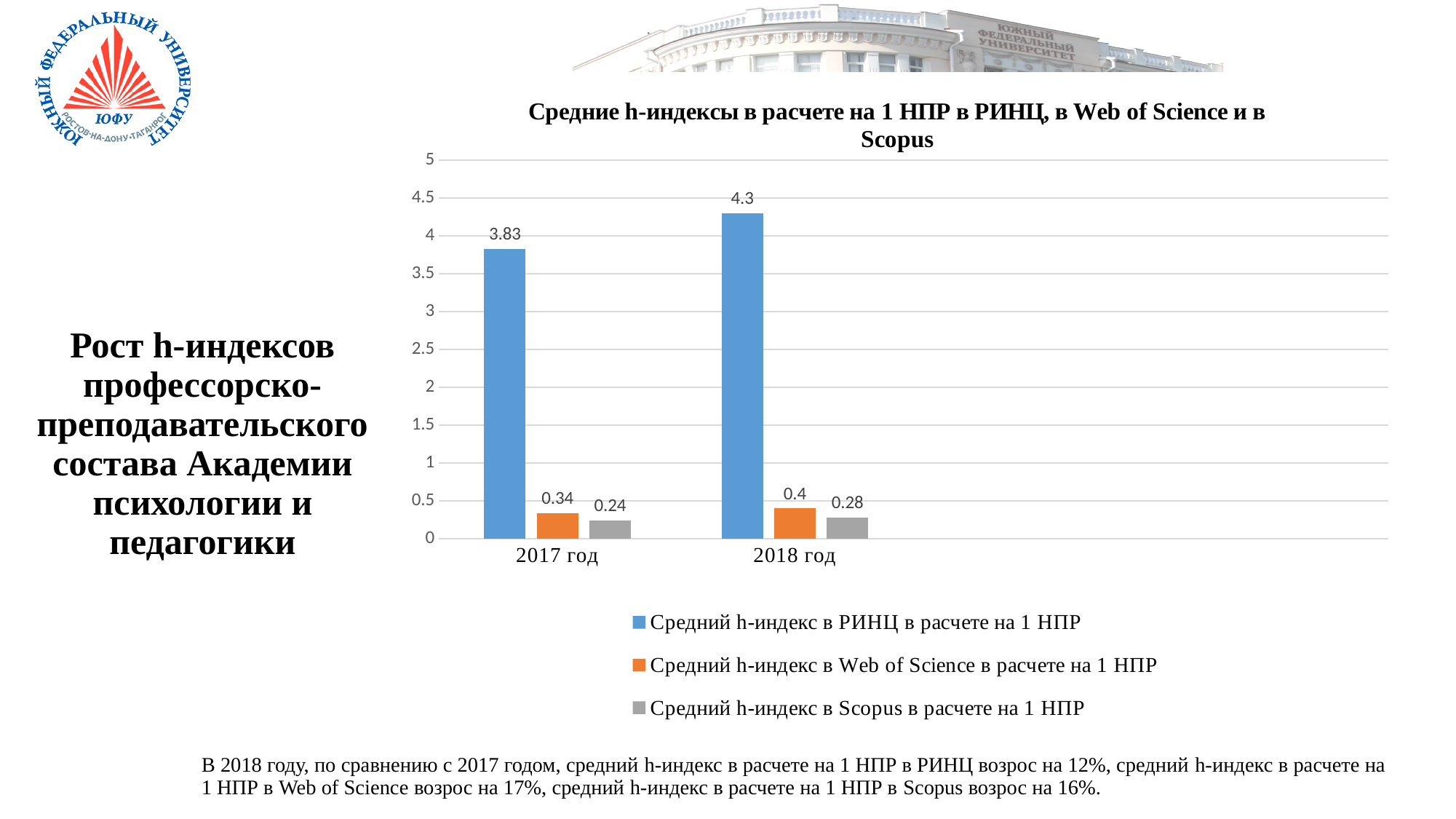
What kind of chart is shown on the slide? bar chart Is the average h-index in РИНЦ per 1 НПР for 2018 год greater or less than 4? greater Which year has the higher average h-index in Scopus per 1 НПР? 2018 год How many year categories are shown on the x axis? 2 What is the average h-index in РИНЦ per 1 НПР for 2017 год? 3.83 Which series has the lowest value in 2018 год? Средний h-индекс в Scopus в расчете на 1 НПР What is the difference between the Web of Science and Scopus average h-indexes in 2017 год? 0.1 How many series does the legend list? 3 What is the average h-index in РИНЦ per 1 НПР for 2018 год? 4.3 By how much did the average h-index in РИНЦ per 1 НПР increase from 2017 год to 2018 год? 0.47 What is the average h-index in Web of Science per 1 НПР for 2018 год? 0.4 What is the average h-index in Scopus per 1 НПР for 2017 год? 0.24